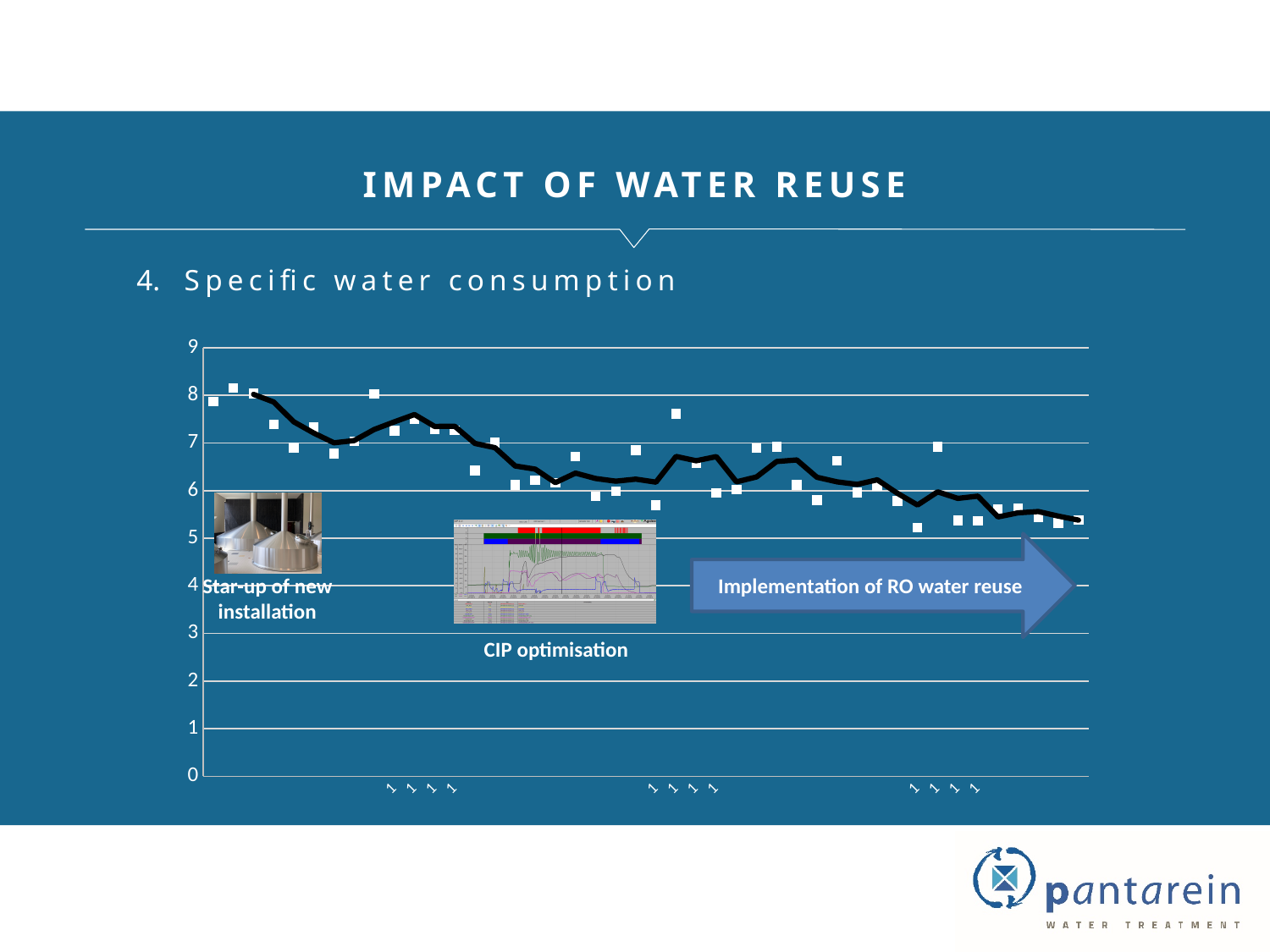
Is the value of the rightmost data point greater or less than 6? less What kind of chart is shown on the slide? line chart Is the value of the leftmost data point greater or less than 7? greater Which is higher, the first data point or the last data point? the first data point What is the highest value shown on the y axis? 9 Does the black trend line start at a value greater or less than 7? greater Do the values of the black trend line rise or fall along the x axis? fall What text is written inside the blue arrow on the chart? Implementation of RO water reuse